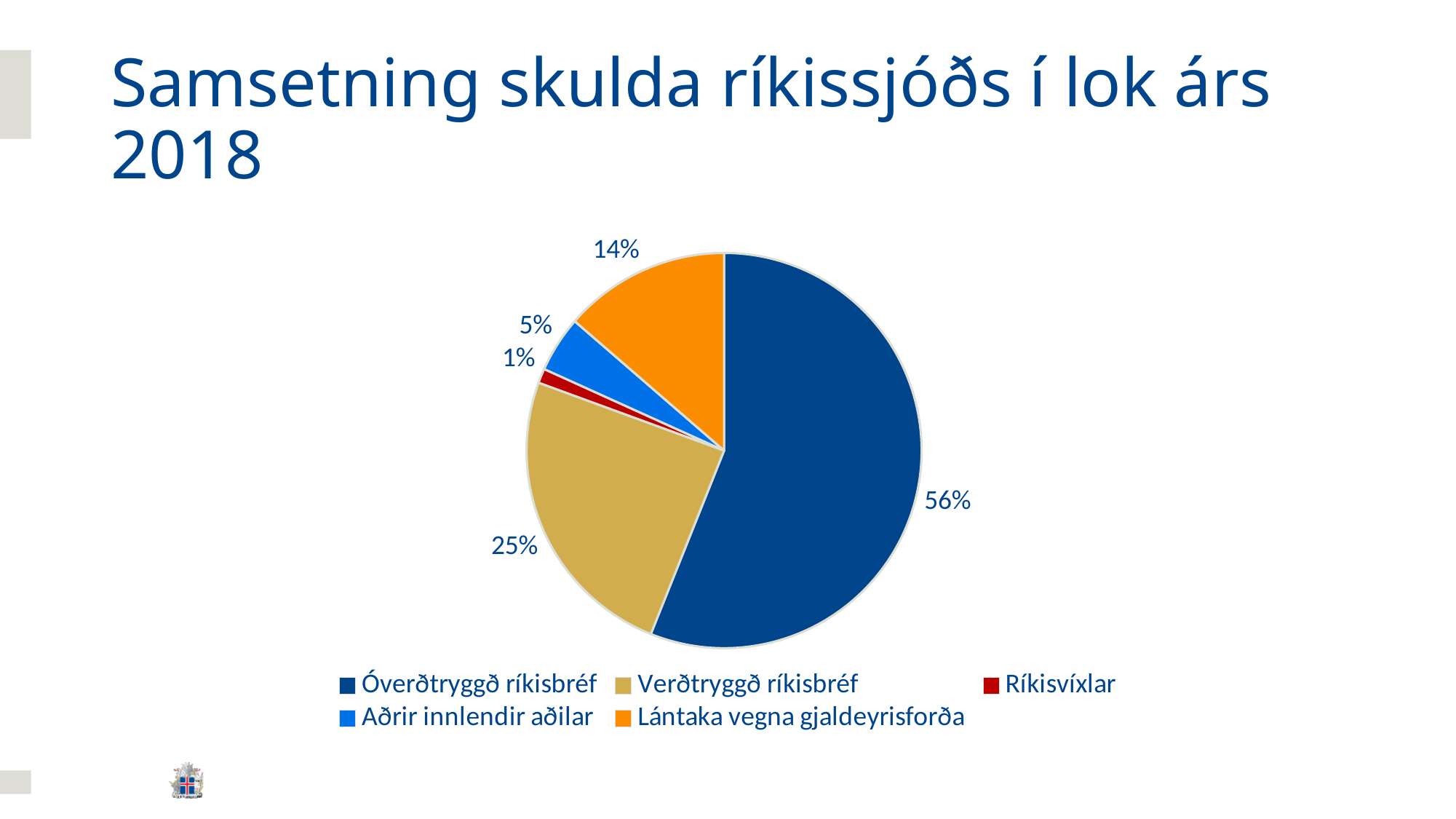
What share of the pie does Ríkisvíxlar represent? 1% What colour is the slice for Ríkisvíxlar? Red Which is larger, the share for Lántaka vegna gjaldeyrisforða or the share for Aðrir innlendir aðilar? Lántaka vegna gjaldeyrisforða Which category has the smallest slice of the pie? Ríkisvíxlar What share of the pie does Óverðtryggð ríkisbréf represent? 56% What share of the pie does Aðrir innlendir aðilar represent? 5% How many categories does the pie chart show? 5 What kind of chart is shown on the slide? Pie chart What is the difference in percentage points between Óverðtryggð ríkisbréf and Verðtryggð ríkisbréf? 31 percentage points Which category has the largest slice of the pie? Óverðtryggð ríkisbréf